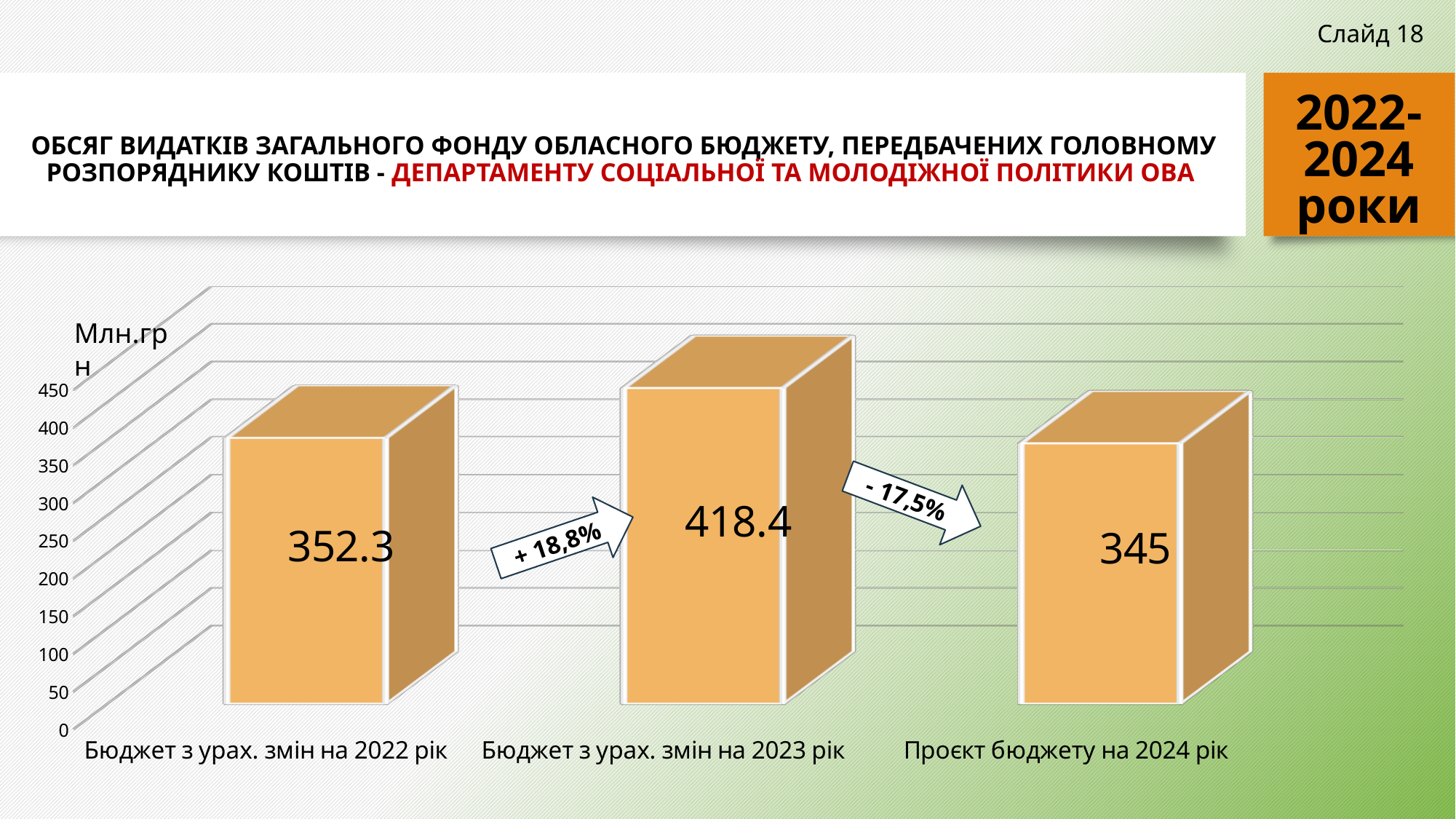
What is the value for 'Бюджет з урах. змін на 2023 рік'? 418.4 What kind of chart is shown on the slide? Bar chart Is the value for 'Бюджет з урах. змін на 2023 рік' greater or less than 400? greater What is the difference between the values for 2023 and 2022? 66.1 Which category has the lowest value? Проєкт бюджету на 2024 рік What is the value for 'Проєкт бюджету на 2024 рік'? 345 What is the value for 'Бюджет з урах. змін на 2022 рік'? 352.3 Which category has the highest value? Бюджет з урах. змін на 2023 рік What percentage change is shown on the arrow between the 2023 and 2024 bars? - 17,5% Which is larger, the value for 2022 or the value for 2024? 2022 (352.3) How many categories are shown in the chart? 3 What is the difference between the values for 2023 and 2024? 73.4